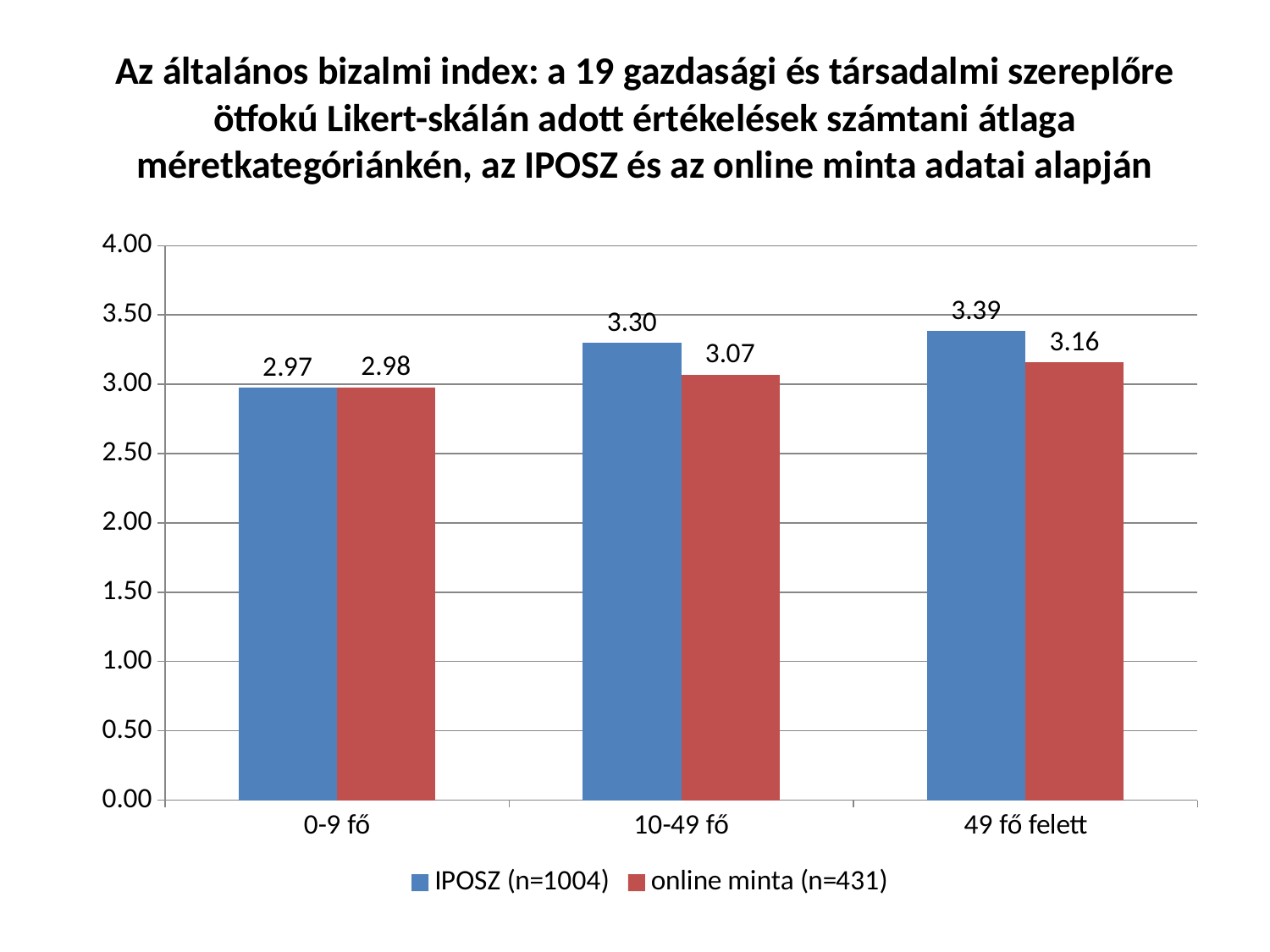
What kind of chart is shown on the slide? bar chart What is the online minta (n=431) value for the 0-9 fő category? 2.98 What is the online minta (n=431) value for the 49 fő felett category? 3.16 How many series does the legend list? 2 What is the IPOSZ (n=1004) value for the 10-49 fő category? 3.30 What is the difference between the IPOSZ (n=1004) values for 49 fő felett and 0-9 fő? 0.42 Which category has the lowest online minta (n=431) value? 0-9 fő What is the difference between the IPOSZ (n=1004) and online minta (n=431) values for the 49 fő felett category? 0.23 For the 10-49 fő category, which series has the larger value, IPOSZ (n=1004) or online minta (n=431)? IPOSZ (n=1004) How many categories are shown on the x axis? 3 Which category has the highest IPOSZ (n=1004) value? 49 fő felett Is the IPOSZ (n=1004) value for 0-9 fő greater or less than 3.00? less